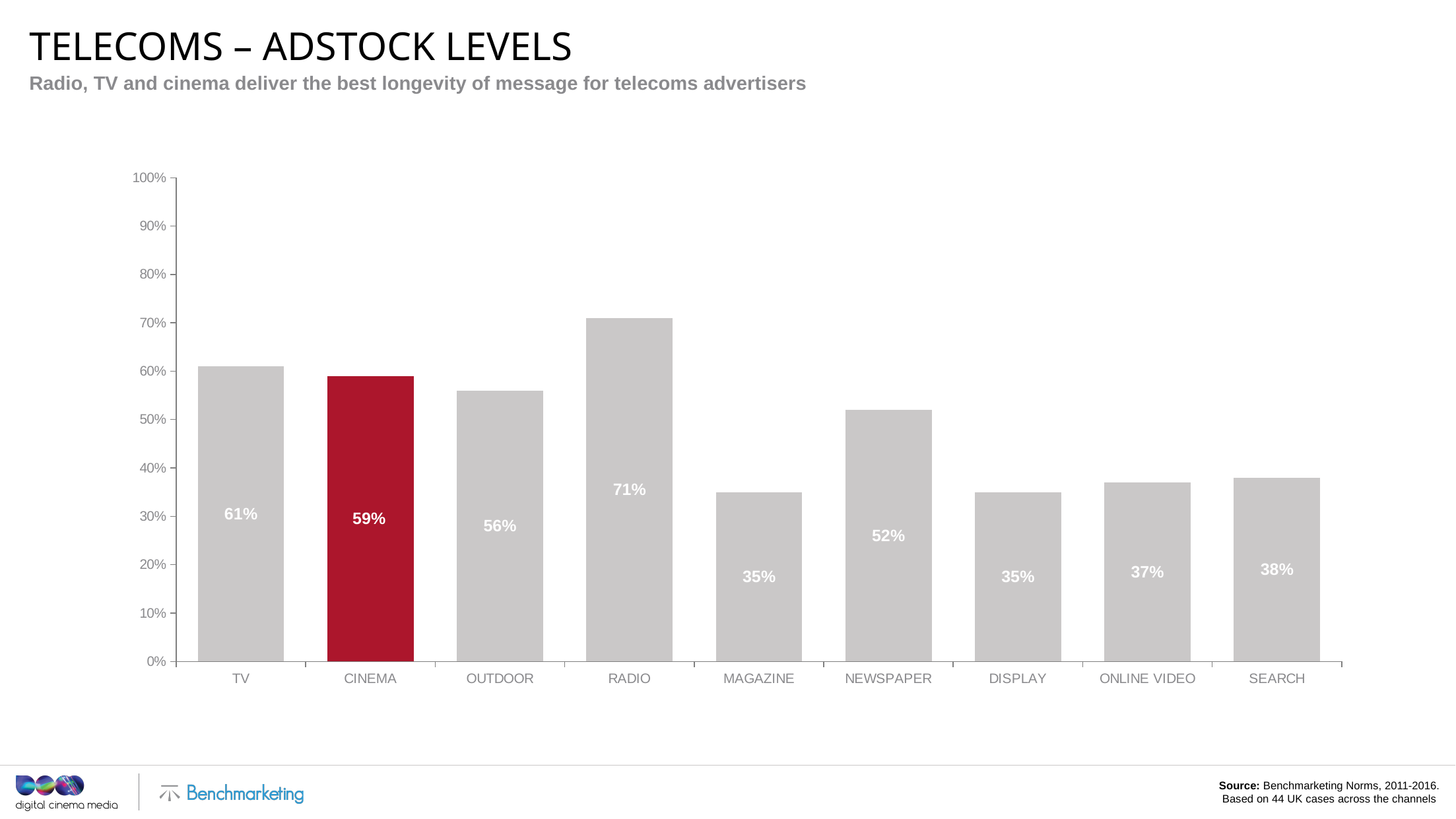
Which bar is highlighted in red? Cinema Which channels share the lowest adstock level? Magazine and Display Is the adstock level for Newspaper greater or less than 50%? greater What type of chart is shown on the slide? Bar chart What is the adstock level for Online Video? 37% Which has a higher adstock level, Search or Magazine? Search What is the adstock level for Radio? 71% Which channel has the highest adstock level? Radio What is the difference between the adstock levels for TV and Outdoor? 5% What is the difference between the adstock levels for Radio and Newspaper? 19% How many channels are shown on the chart? 9 What is the adstock level for Cinema? 59%